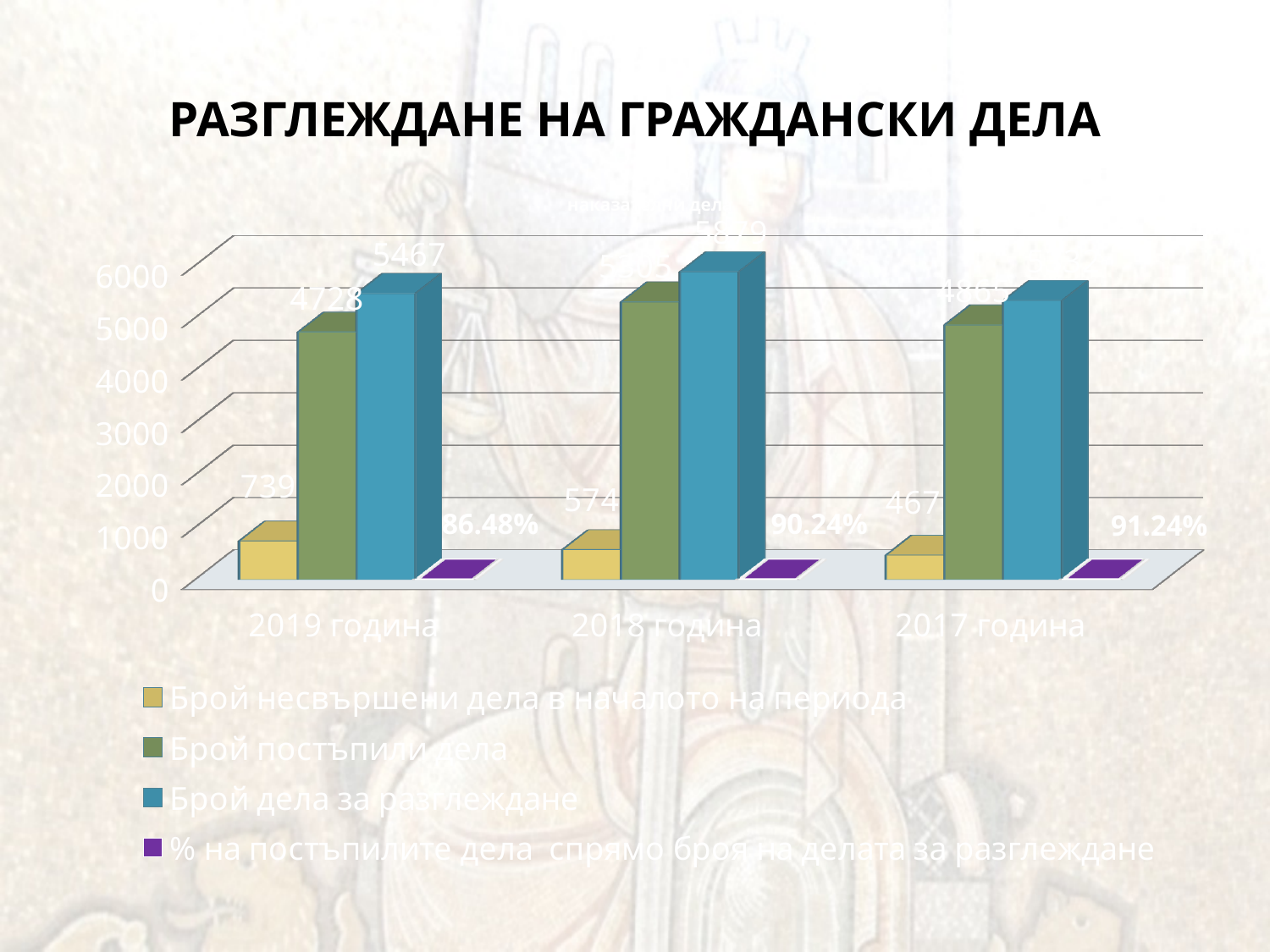
What percentage is shown for % на постъпилите дела спрямо броя на делата за разглеждане in 2018 година? 90.24% What is the value of Брой несвършени дела в началото на периода for 2019 година? 739 Which year has the highest value for Брой несвършени дела в началото на периода? 2019 година How many series does the legend list? 4 Which year has the larger value for Брой дела за разглеждане, 2019 година or 2018 година? 2018 година What kind of chart is shown on the slide? bar chart What is the difference between Брой несвършени дела в началото на периода for 2019 година and 2018 година? 165 What percentage is shown for % на постъпилите дела спрямо броя на делата за разглеждане in 2017 година? 91.24% Is the value of Брой дела за разглеждане for 2018 година greater or less than 5000? greater What is the value of Брой несвършени дела в началото на периода for 2017 година? 467 What is the value of Брой постъпили дела for 2019 година? 4728 What is the value of Брой дела за разглеждане for 2019 година? 5467